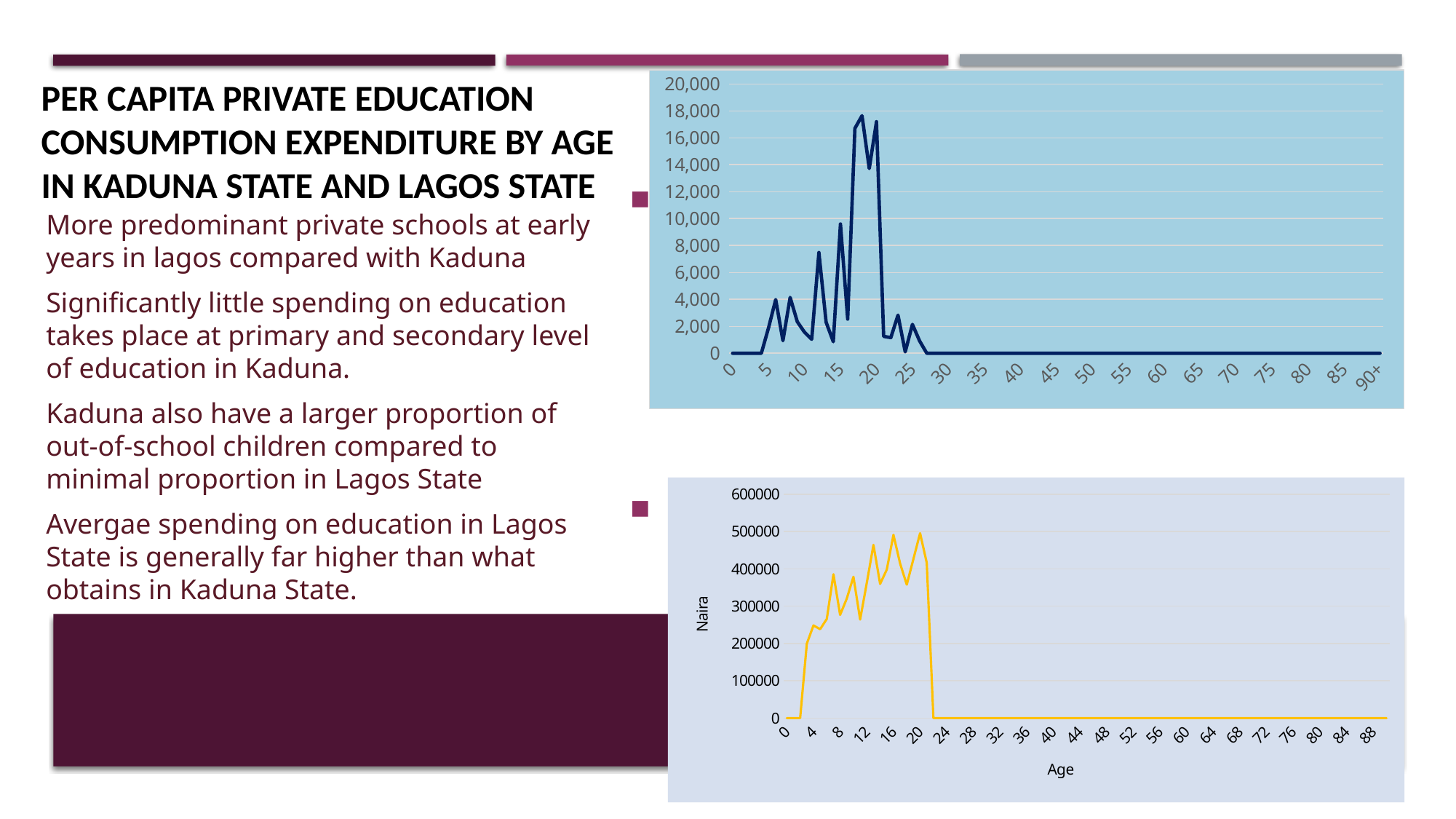
In the top chart, is the peak value of the line greater or less than 16,000? greater In the bottom chart, is the value at age 60 greater or less than 100000? less What is the highest value shown on the vertical axis of the top chart? 20,000 In the top chart, is the value at age 50 greater or less than 2,000? less What kind of chart is the bottom chart on the slide? line chart How many lines are plotted in the bottom chart? 1 What kind of chart is the top chart on the slide? line chart In the bottom chart, does the line rise or fall between age 0 and age 4? rise In the top chart, does the line rise or fall between age 20 and age 30? fall What is the label on the horizontal axis of the bottom chart? Age